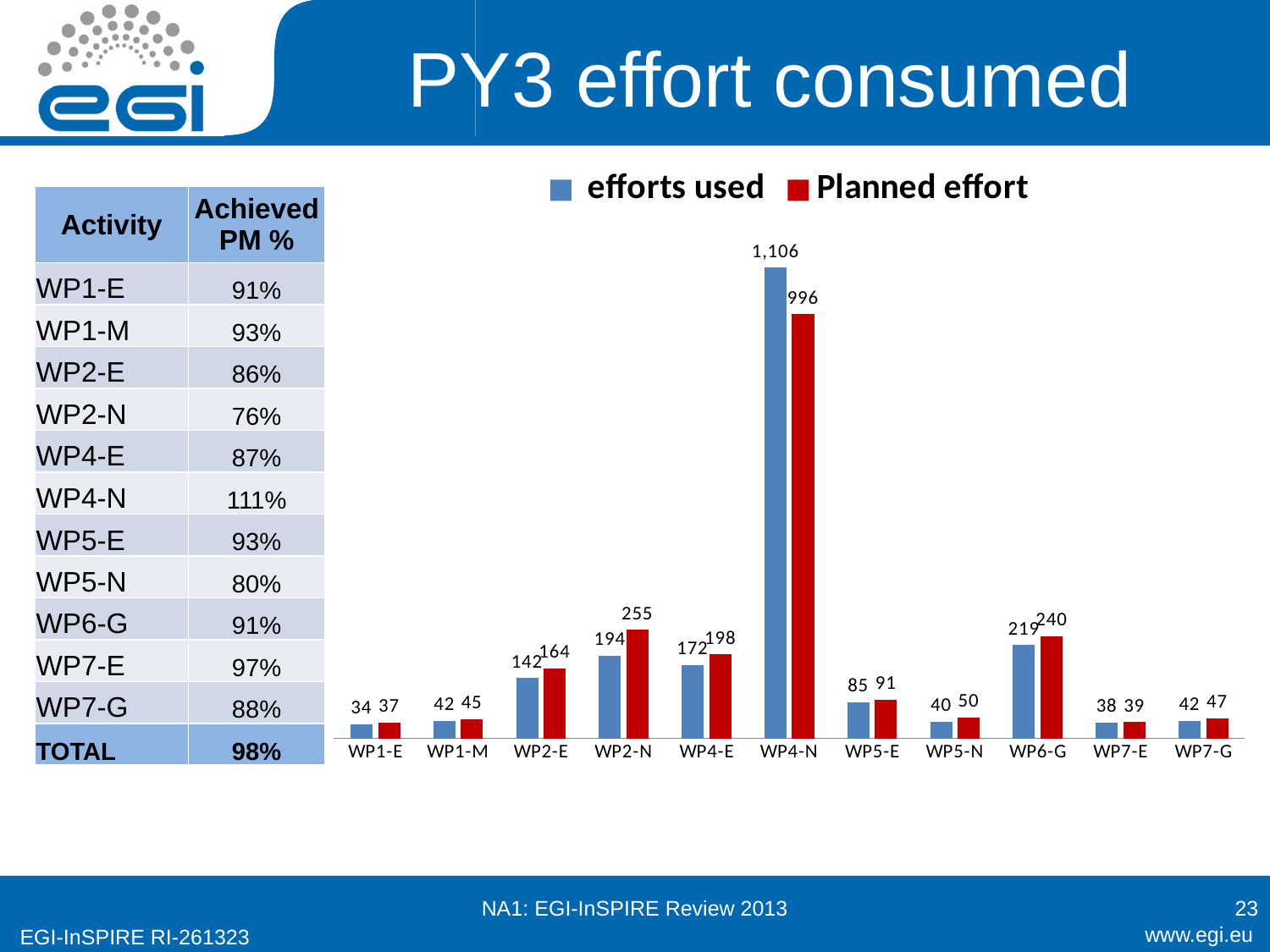
What is the Planned effort for WP2-N? 255 For WP4-N, which is larger: efforts used or Planned effort? efforts used Which series is shown in red in the chart? Planned effort What is the value of efforts used for WP6-G? 219 What is the difference between Planned effort and efforts used for WP2-N? 61 How many series does the chart legend list? 2 Which category has the lowest efforts used? WP1-E Which category has the highest Planned effort? WP4-N What kind of chart is shown on the slide? Bar chart Is the Planned effort for WP2-E larger than the Planned effort for WP4-E? No How many work package categories are shown on the x axis of the chart? 11 What is the value of efforts used for WP4-N? 1,106